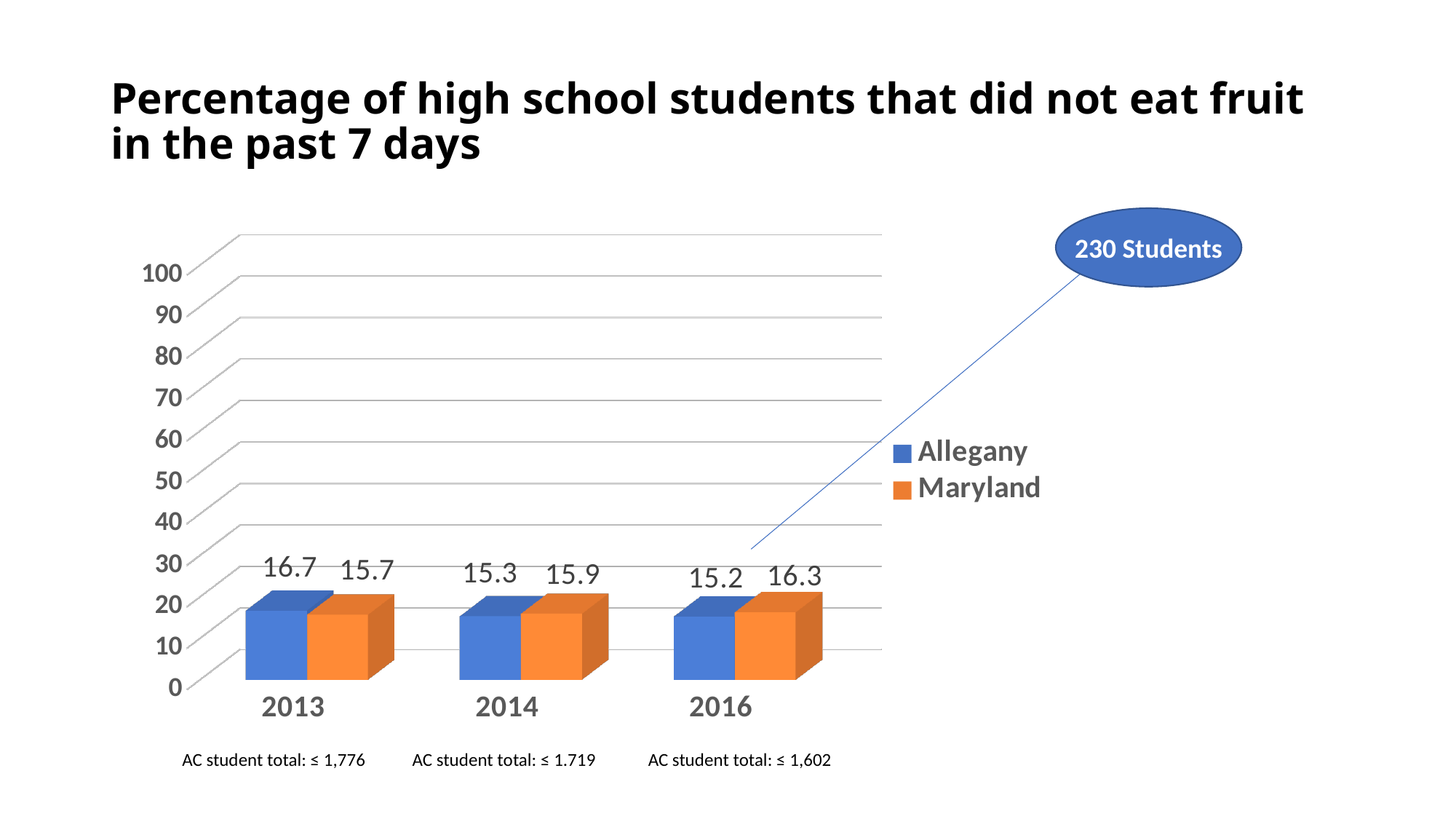
In which year is the Allegany value lowest? 2016 In which year is the Allegany value highest? 2013 What is the value for Maryland in 2014? 15.9 What is the value for Maryland in 2016? 16.3 Is the value for Allegany in 2013 greater or less than 20? less What is the value for Allegany in 2014? 15.3 What is the difference between the Allegany and Maryland values in 2013? 1.0 What kind of chart is shown on the slide? bar chart How many years are shown on the x axis? 3 How many series does the legend list? 2 Which is larger in 2016, the Allegany value or the Maryland value? Maryland What is the value for Allegany in 2013? 16.7